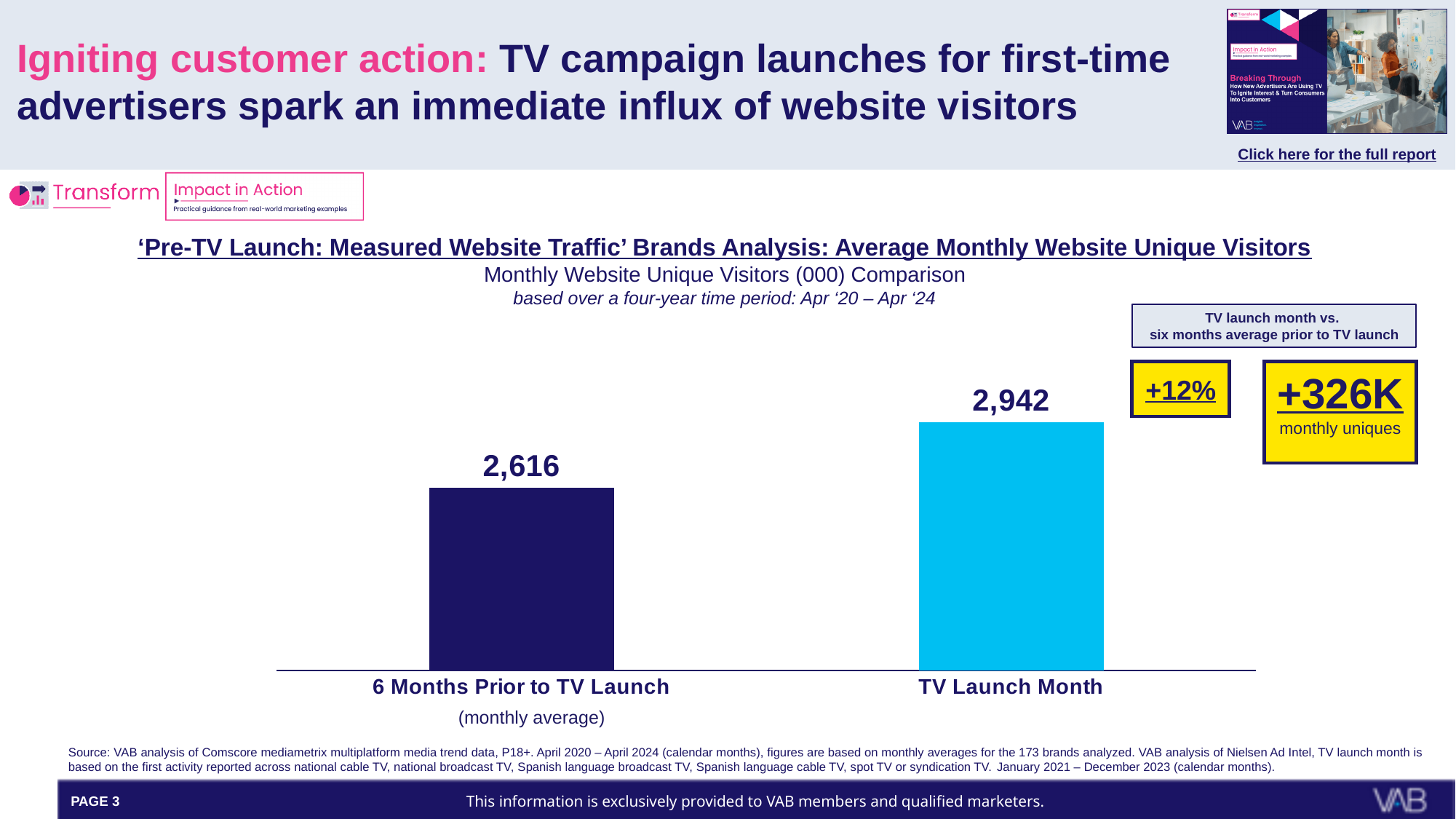
Which category has the higher value? TV Launch Month What kind of chart is shown on the slide? bar chart Is the value for TV Launch Month larger or smaller than the value for 6 Months Prior to TV Launch? larger How many categories are plotted in the chart? 2 What is the value for '6 Months Prior to TV Launch'? 2,616 What is the difference between the TV Launch Month value and the 6 Months Prior to TV Launch value? 326 Do the values rise or fall from left to right across the chart? rise What percentage change is shown in the callout box comparing TV launch month to the six months average prior to TV launch? +12% What is the subtitle of the chart directly below the underlined title? Monthly Website Unique Visitors (000) Comparison Which category has the lower value? 6 Months Prior to TV Launch What is the value for 'TV Launch Month'? 2,942